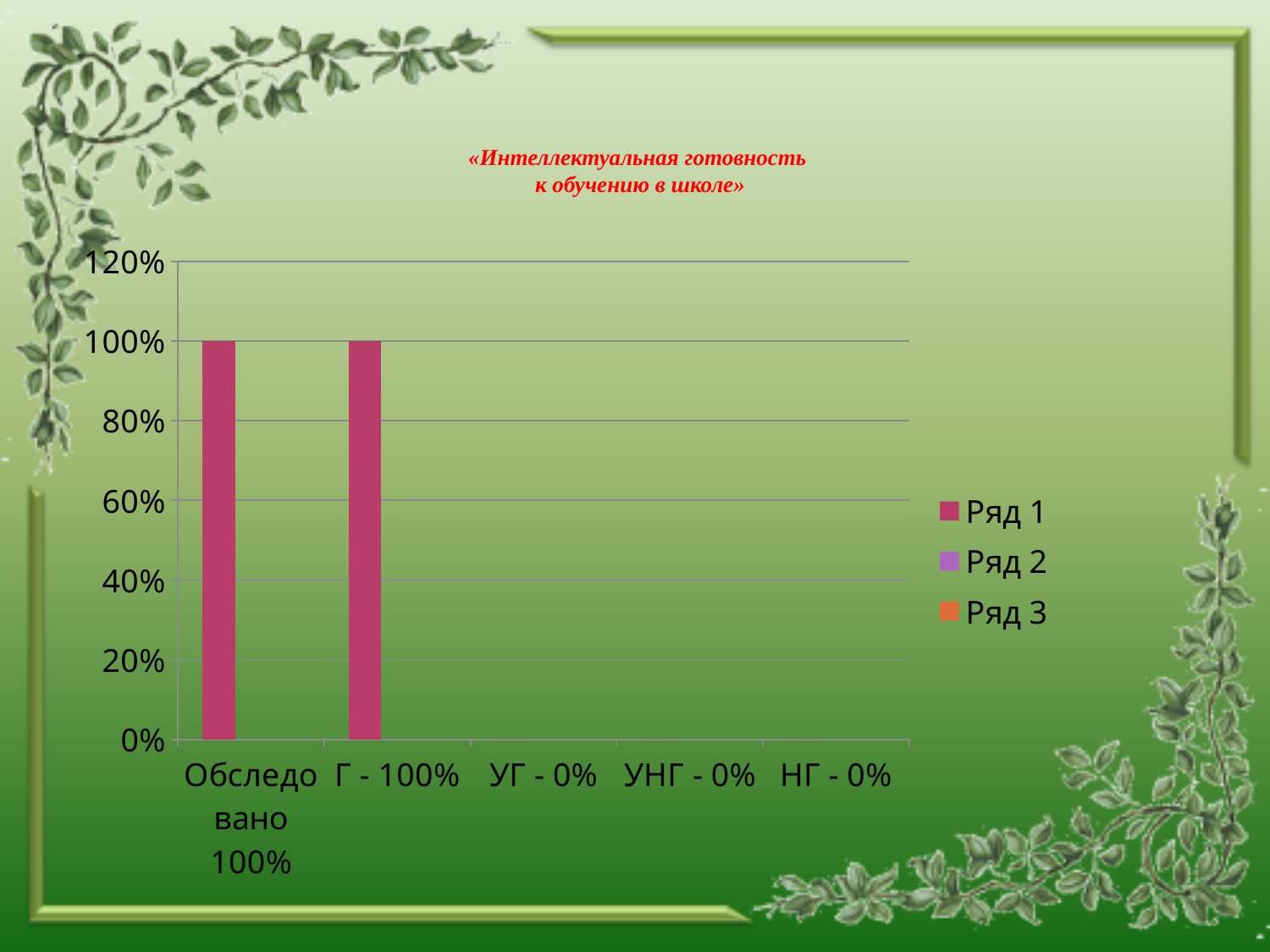
What is the value for the category "УГ - 0%"? 0% What is the difference between the value for "Г - 100%" and the value for "УГ - 0%"? 100% What is the value of the bar for the category "Обследовано 100%"? 100% Is the value for "Г - 100%" greater or less than 80%? greater What kind of chart is shown on the slide? bar chart What is the title of the chart? «Интеллектуальная готовность к обучению в школе» What is the value for the category "НГ - 0%"? 0% How many series does the legend list? 3 What is the name of the first series in the legend? Ряд 1 Which is larger, the value for "Г - 100%" or the value for "УНГ - 0%"? Г - 100% How many categories are shown on the x axis? 5 What is the value of the bar for the category "Г - 100%"? 100%